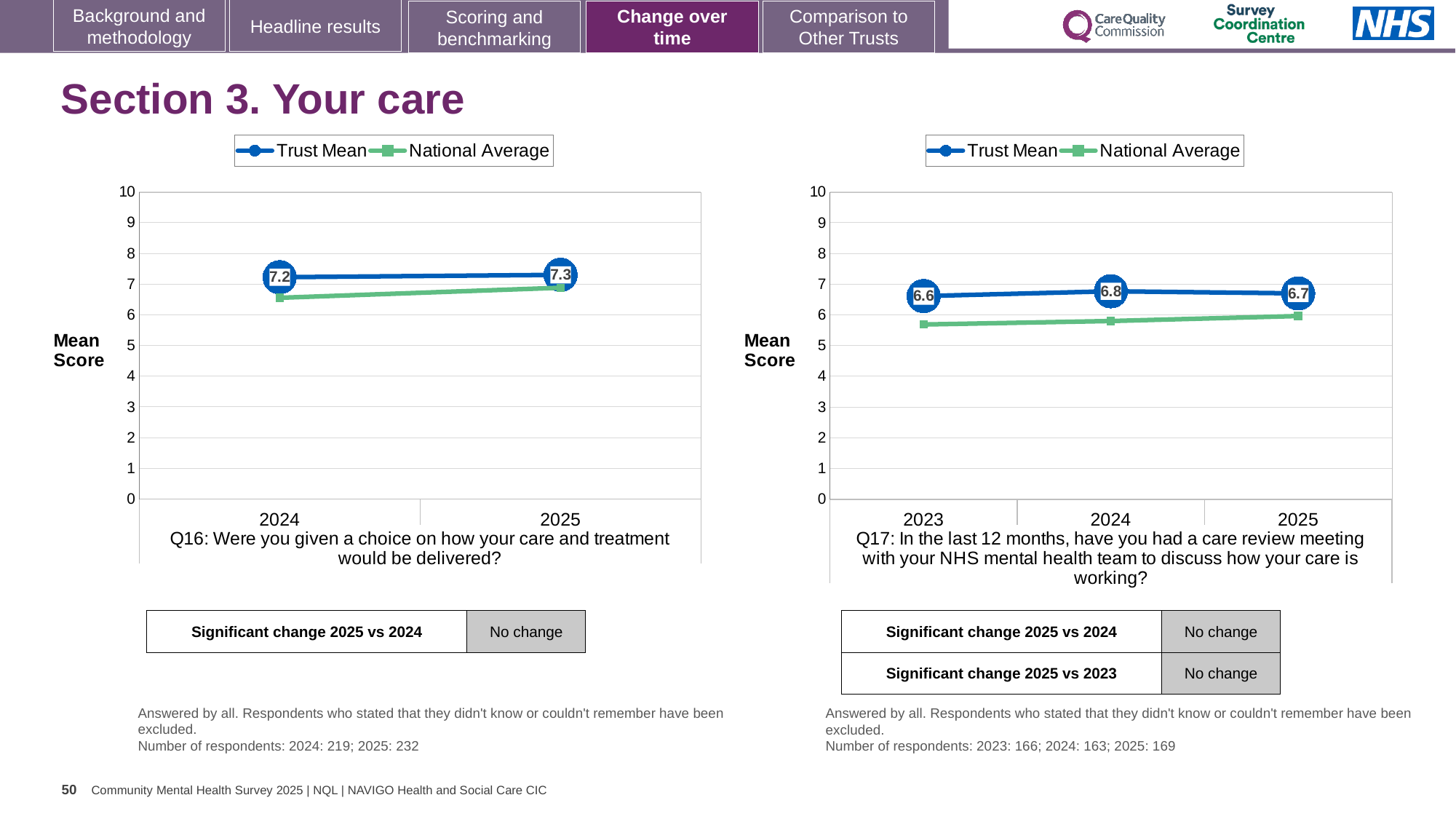
In the Q17 chart on the right, what is the Trust Mean for 2024? 6.8 What type of chart is the Q16 chart on the left? Line chart In the Q16 chart on the left, is the National Average for 2024 greater or less than 7? less In the Q16 chart on the left, what is the Trust Mean for 2025? 7.3 In the Q17 chart on the right, what is the Trust Mean for 2023? 6.6 In the Q16 chart on the left, what is the Trust Mean for 2024? 7.2 In the Q17 chart on the right, what is the difference between the Trust Mean for 2024 and 2023? 0.2 In the Q17 chart on the right, which year has the highest Trust Mean? 2024 In the Q17 chart on the right, what is the Trust Mean for 2025? 6.7 In the Q17 chart on the right, which year has the lowest Trust Mean? 2023 How many years are plotted on the x axis of the Q17 chart on the right? 3